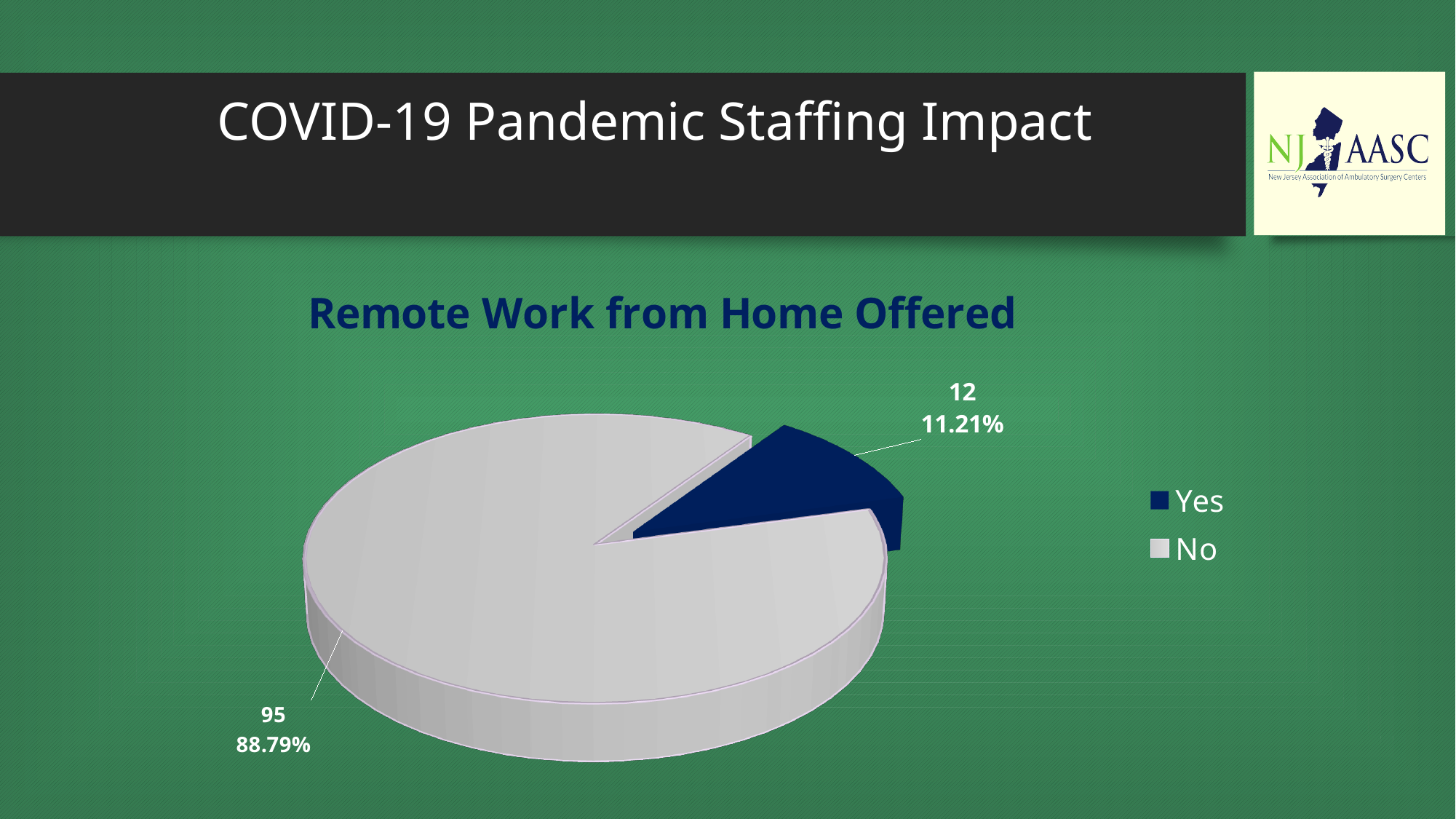
How many categories does the legend list? 2 What colour is the Yes slice? Dark blue Which is larger, the Yes count or the No count? No What type of chart is shown on the slide? Pie chart How many respondents answered No? 95 How many respondents answered Yes? 12 What percentage share of the pie is the No slice? 88.79% What percentage share of the pie is the Yes slice? 11.21% Which category has the smallest slice of the pie? Yes Which category has the largest slice of the pie? No What is the title of the chart? Remote Work from Home Offered What is the difference between the number of No responses and Yes responses? 83